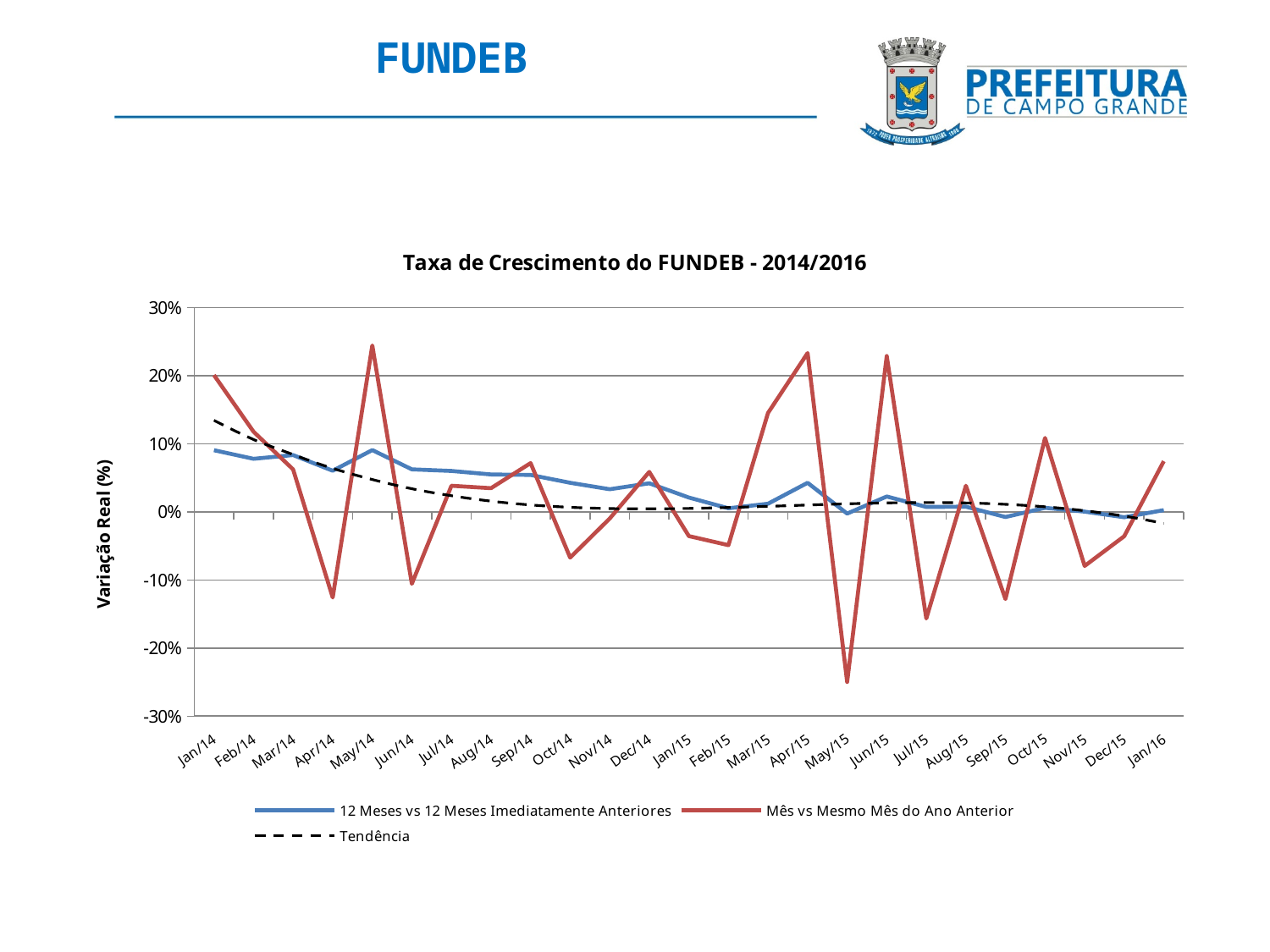
For Jan/14, which series has the higher value: '12 Meses vs 12 Meses Imediatamente Anteriores' or 'Mês vs Mesmo Mês do Ano Anterior'? Mês vs Mesmo Mês do Ano Anterior Is the value of 'Mês vs Mesmo Mês do Ano Anterior' for May/15 greater or less than -20%? less How many series does the legend list? 3 Is the value of 'Mês vs Mesmo Mês do Ano Anterior' for May/14 greater or less than 20%? greater How many months are plotted along the x axis? 25 In which month does the 'Mês vs Mesmo Mês do Ano Anterior' series reach its lowest value? May/15 Does the '12 Meses vs 12 Meses Imediatamente Anteriores' series generally rise or fall from Jan/14 to Jan/16? fall Is the value of '12 Meses vs 12 Meses Imediatamente Anteriores' for Jan/14 greater or less than 10%? less What kind of chart is shown on the slide? line chart What is the title of the chart? Taxa de Crescimento do FUNDEB - 2014/2016 What is the label of the vertical axis? Variação Real (%)